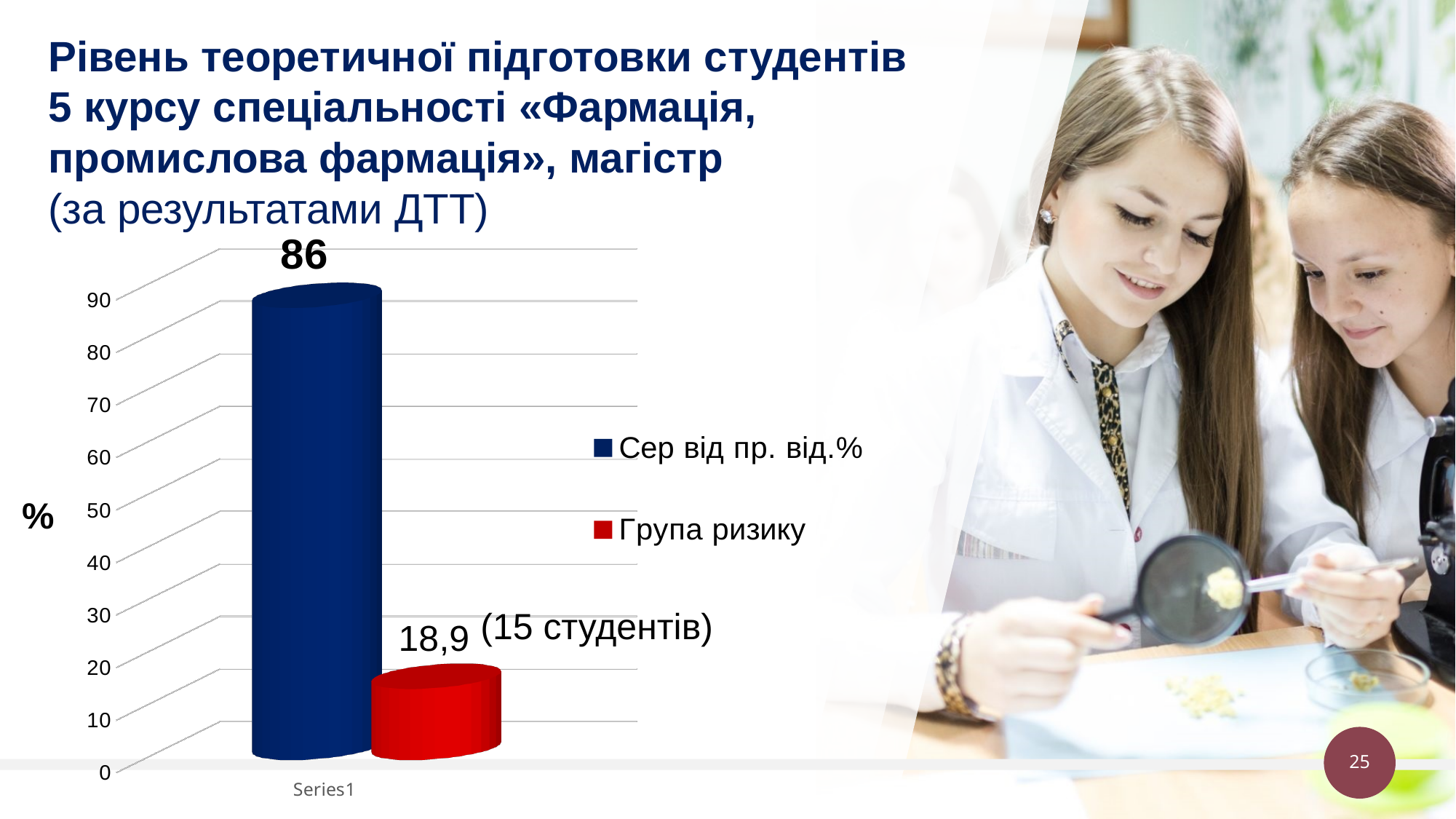
Which series has the lowest value on the chart? Група ризику What is the value for the series "Група ризику"? 18,9 What is the label on the vertical axis of the chart? % What kind of chart is shown on the slide? bar chart What is the difference between the values for "Сер від пр. від.%" and "Група ризику"? 67,1 What is the value for the series "Сер від пр. від.%"? 86 How many series does the legend list? 2 Is the value for "Сер від пр. від.%" greater or less than 80? greater What colour is the bar for "Група ризику"? red Which series has the higher value, "Сер від пр. від.%" or "Група ризику"? Сер від пр. від.% How many students does the annotation next to the "Група ризику" bar mention? 15 студентів Is the value for "Група ризику" greater or less than 20? less